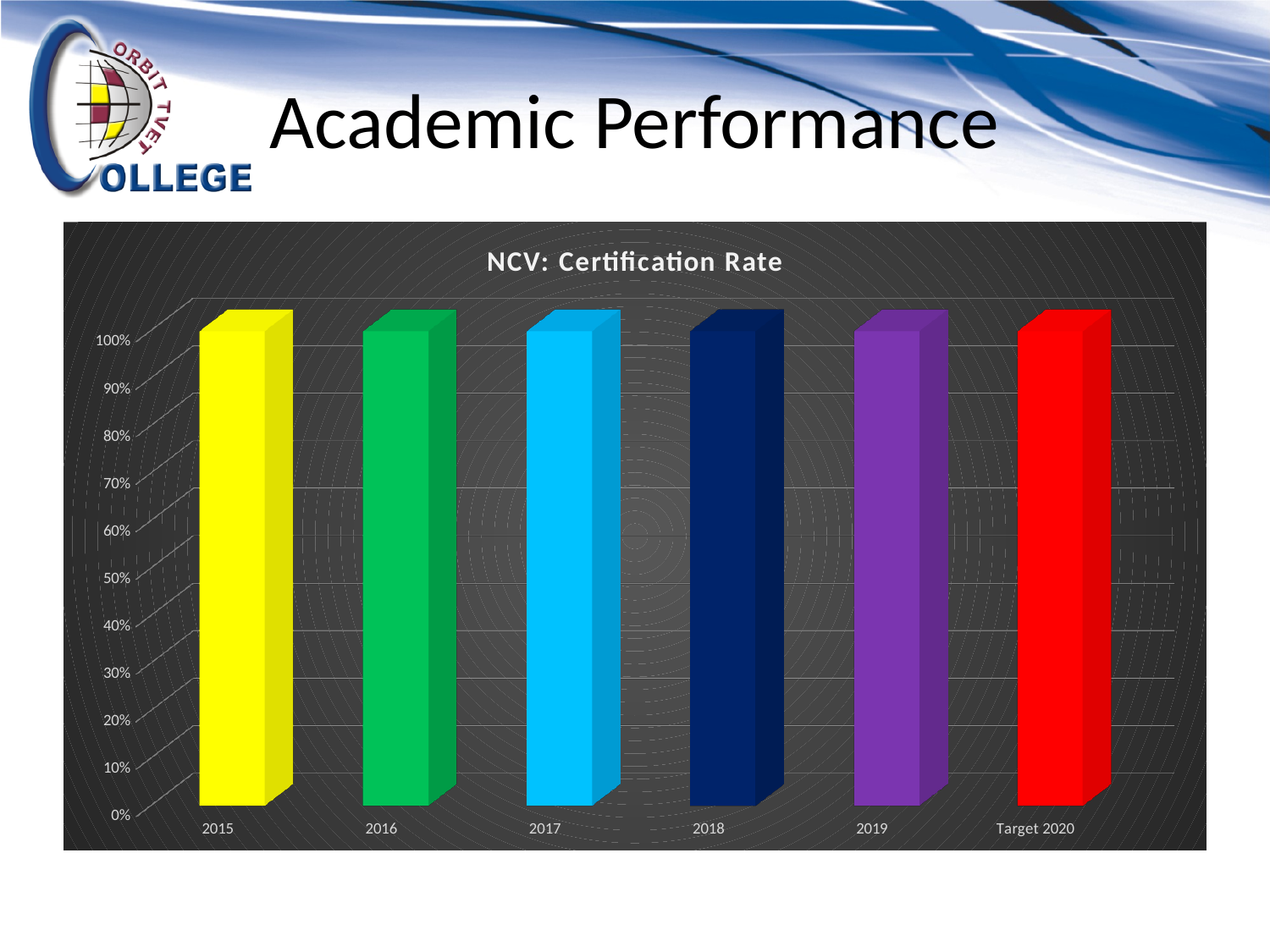
Do the values rise, fall, or stay flat from 2015 to Target 2020? stay flat Is the value for 2015 greater or less than 90%? greater Is the value for 2018 greater or less than 60%? greater Is the value for 2019 greater or less than 80%? greater What is the title of the chart? NCV: Certification Rate What kind of chart is shown on the slide? bar chart How many categories are shown on the x axis of the chart? 6 What colour is the bar for 2016? green What is the certification rate shown for Target 2020? 100% What is the label of the last category on the x axis? Target 2020